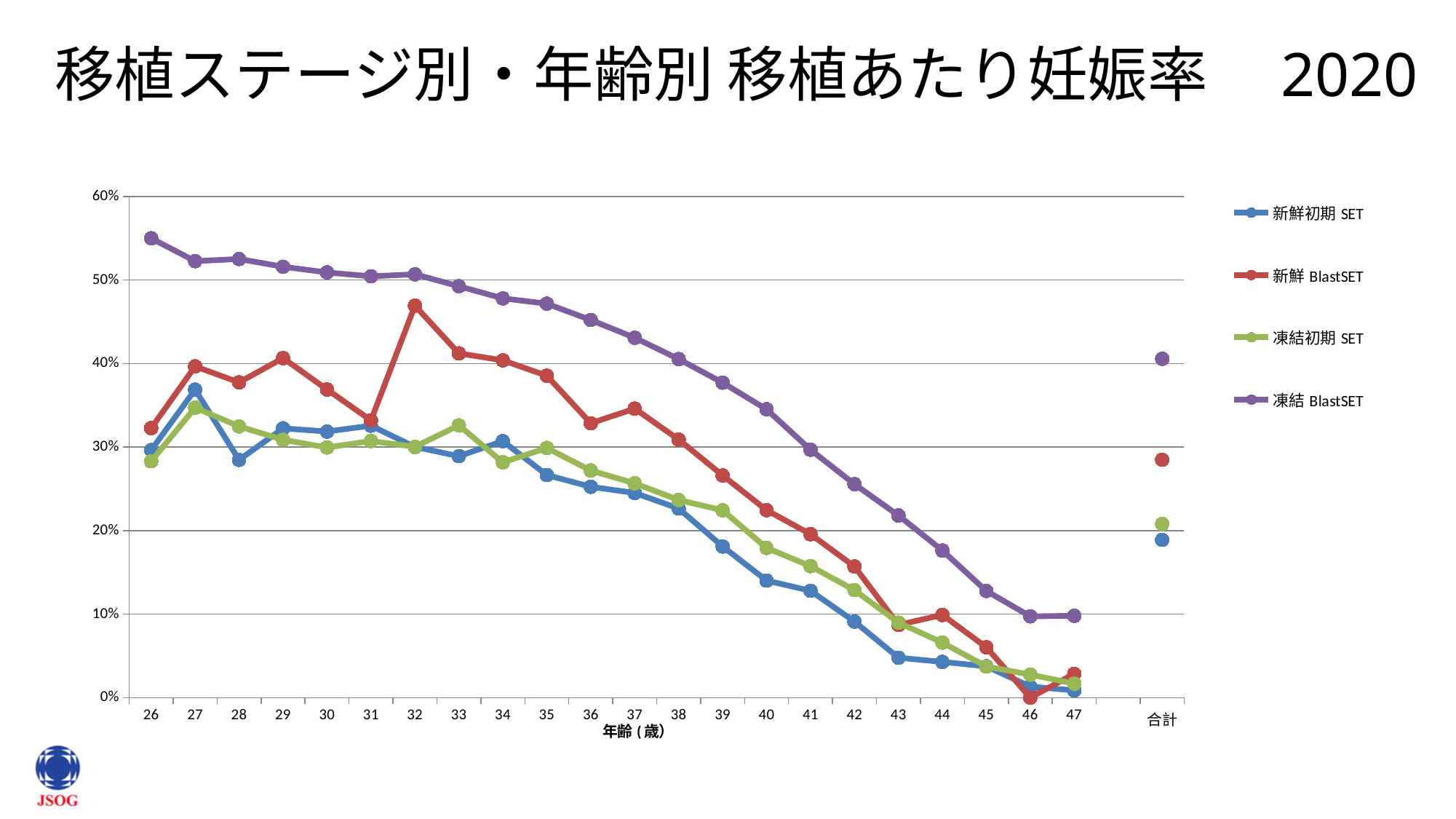
Is the value for 新鮮初期 SET at age 43 greater or less than 10%? less Does the 凍結 BlastSET series rise or fall as age increases from 26 to 47? fall How many series does the legend list? 4 Is the value for 新鮮 BlastSET at age 32 greater or less than 40%? greater Which series has the lowest value at age 46? 新鮮 BlastSET At which age is the 凍結 BlastSET value highest? 26 How many age categories (excluding 合計) are shown on the x axis? 22 At age 39, which is larger: 新鮮初期 SET or 凍結初期 SET? 凍結初期 SET Is the 合計 value for 新鮮初期 SET greater or less than 20%? less Which series has the highest value at age 30? 凍結 BlastSET What kind of chart is shown on the slide? line chart